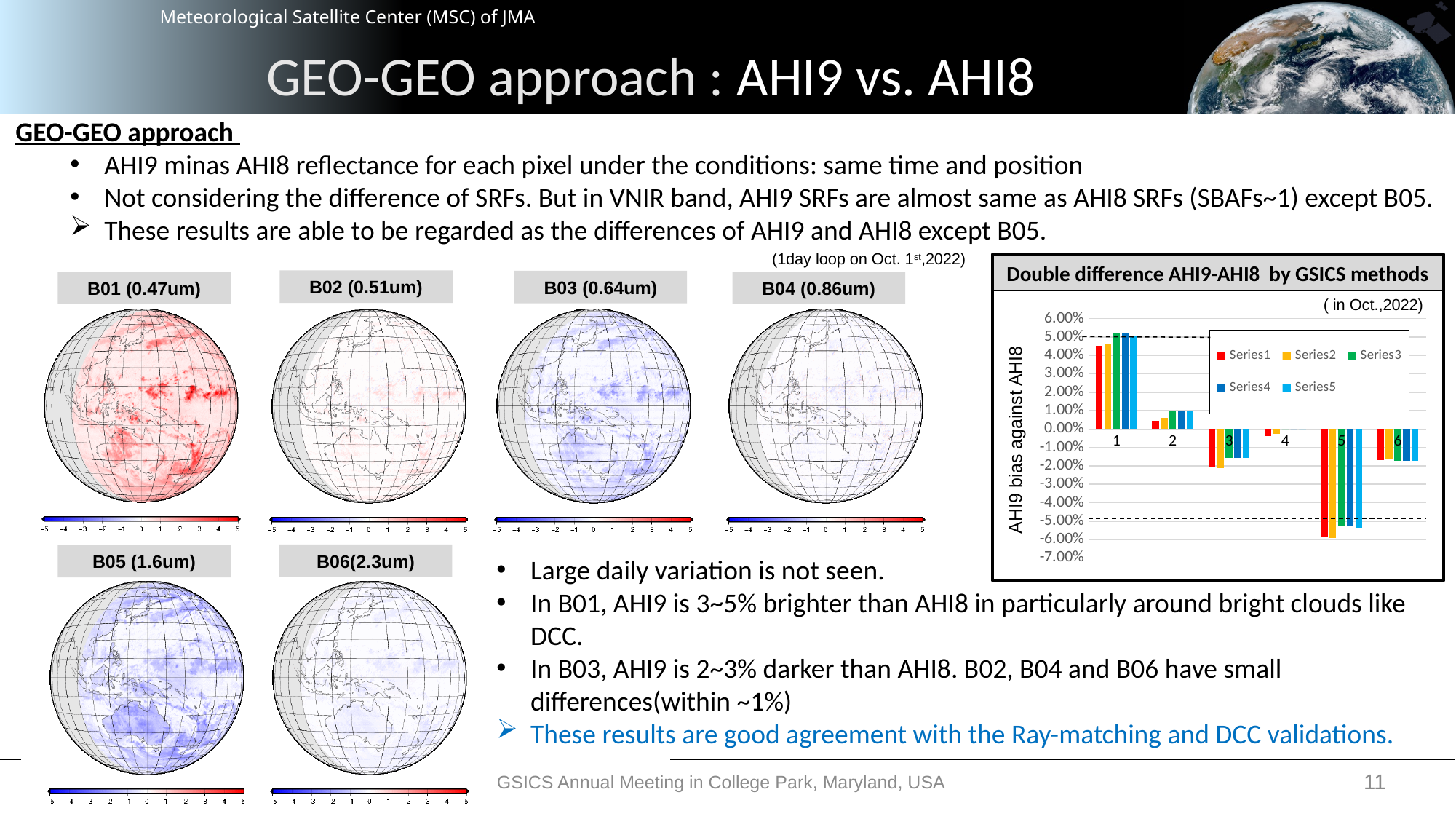
How many categories are shown on the x axis of the "Double difference AHI9-AHI8 by GSICS methods" chart? 6 In the "Double difference AHI9-AHI8 by GSICS methods" chart, which category has the highest values? 1 In the "Double difference AHI9-AHI8 by GSICS methods" chart, is the Series1 value for category 2 greater or less than 1.00%? less In the "Double difference AHI9-AHI8 by GSICS methods" chart, which is larger for Series3: the value for category 1 or the value for category 3? category 1 How many series does the legend of the "Double difference AHI9-AHI8 by GSICS methods" chart list? 5 What is the y-axis title of the "Double difference AHI9-AHI8 by GSICS methods" chart? AHI9 bias against AHI8 In the "Double difference AHI9-AHI8 by GSICS methods" chart, is the Series1 value for category 3 greater or less than -1.00%? less What kind of chart is shown under the title "Double difference AHI9-AHI8 by GSICS methods"? bar chart In the "Double difference AHI9-AHI8 by GSICS methods" chart, is the Series1 value for category 1 greater or less than 4.00%? greater In the "Double difference AHI9-AHI8 by GSICS methods" chart, which category has the lowest values? 5 In the "Double difference AHI9-AHI8 by GSICS methods" chart, which is larger for Series1: the value for category 4 or the value for category 5? category 4